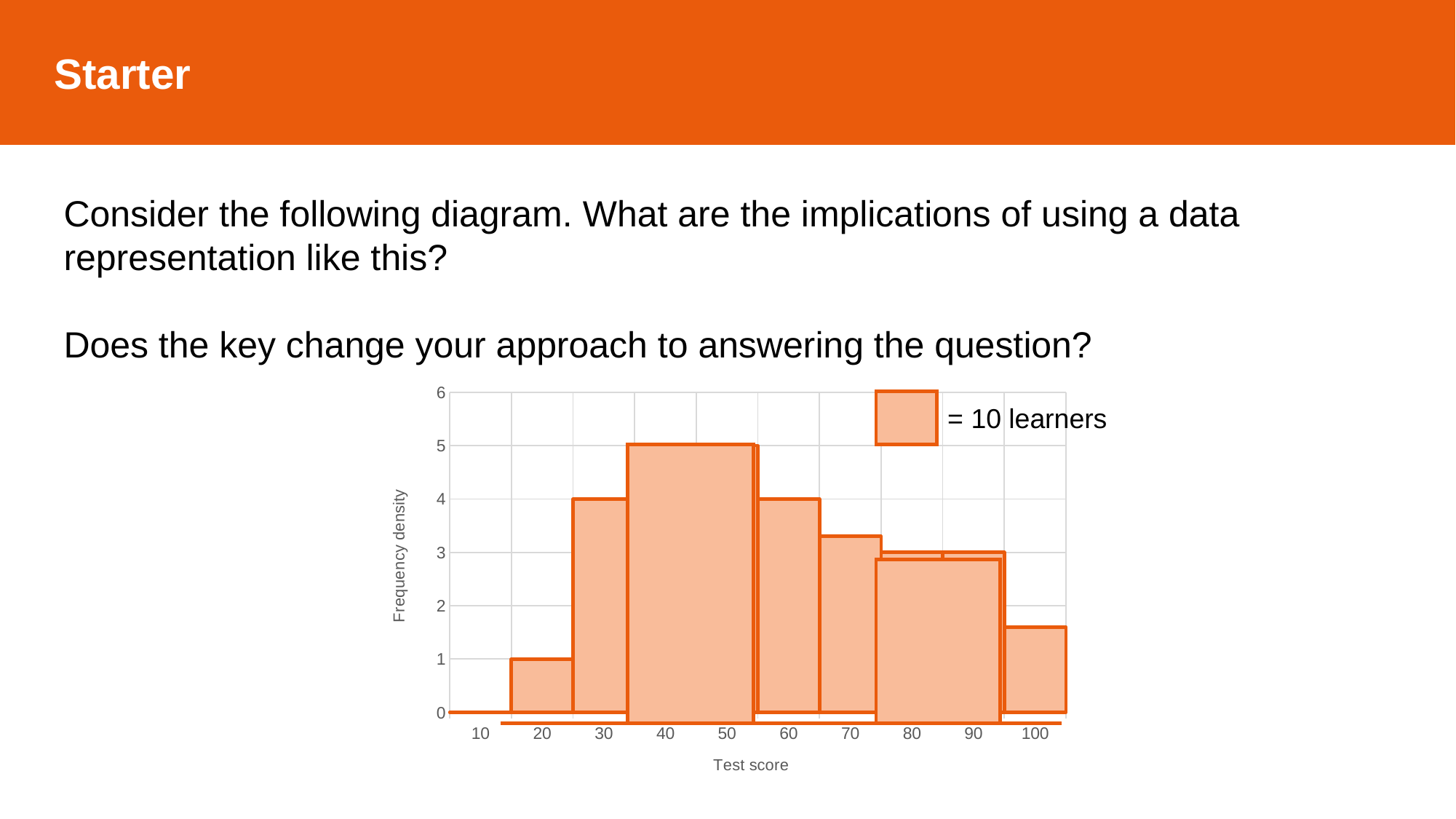
Which test score range has the highest frequency density? 35 to 55 Is the frequency density for the 65 to 75 bar greater or less than 3? greater What kind of chart is shown on the slide? Bar chart (histogram) What is the frequency density of the bar spanning test scores 55 to 65? 4 What is the label of the y axis? Frequency density What is the frequency density of the bar spanning test scores 25 to 35? 4 What is the frequency density of the bar spanning test scores 15 to 25? 1 Is the frequency density for the 95 to 105 bar greater or less than 2? less According to the key, how many learners does one square represent? 10 learners Which test score range has the lowest frequency density? 15 to 25 What is the frequency density of the bar spanning test scores 35 to 55? 5 Which has the larger frequency density, the 25 to 35 bar or the 15 to 25 bar? 25 to 35